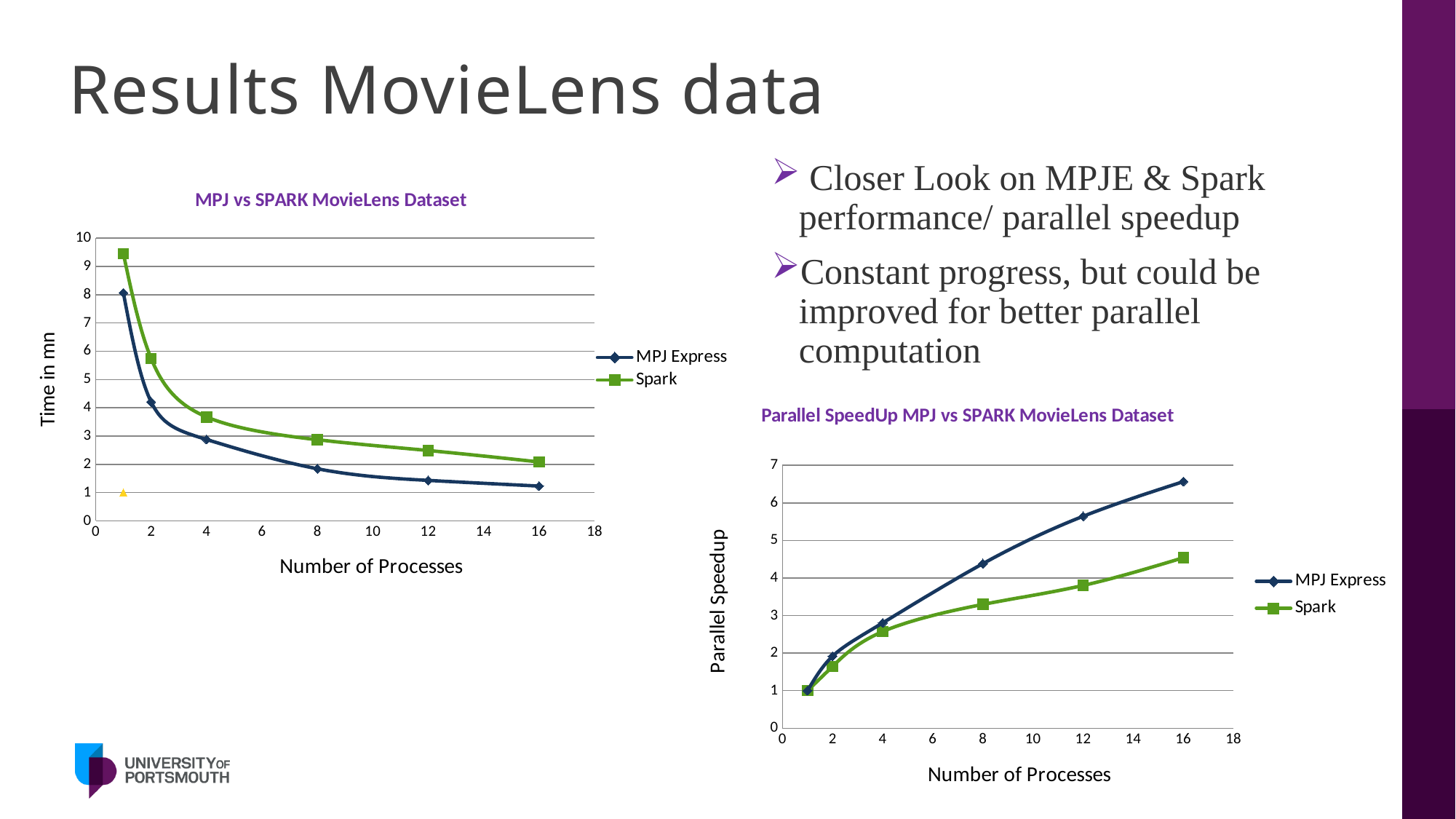
In the 'Parallel SpeedUp MPJ vs SPARK MovieLens Dataset' chart, does the speedup for Spark rise or fall as the number of processes increases? rise In the 'Parallel SpeedUp MPJ vs SPARK MovieLens Dataset' chart, is the MPJ Express speedup at 16 processes greater or less than 6? greater In the 'Parallel SpeedUp MPJ vs SPARK MovieLens Dataset' chart, is the Spark speedup at 8 processes greater or less than 4? less In the 'MPJ vs SPARK MovieLens Dataset' chart, is the MPJ Express value at 16 processes greater or less than 2? less In the 'MPJ vs SPARK MovieLens Dataset' chart, how many data points are plotted for the Spark series? 6 What kind of chart is the 'MPJ vs SPARK MovieLens Dataset' chart? line chart In the 'MPJ vs SPARK MovieLens Dataset' chart, does the time for MPJ Express rise or fall as the number of processes increases? fall What is the y-axis label of the 'MPJ vs SPARK MovieLens Dataset' chart? Time in mn In the 'MPJ vs SPARK MovieLens Dataset' chart, which series has the higher time at 4 processes, MPJ Express or Spark? Spark How many series does the legend of the 'Parallel SpeedUp MPJ vs SPARK MovieLens Dataset' chart list? 2 In the 'Parallel SpeedUp MPJ vs SPARK MovieLens Dataset' chart, which series has the higher speedup at 16 processes? MPJ Express